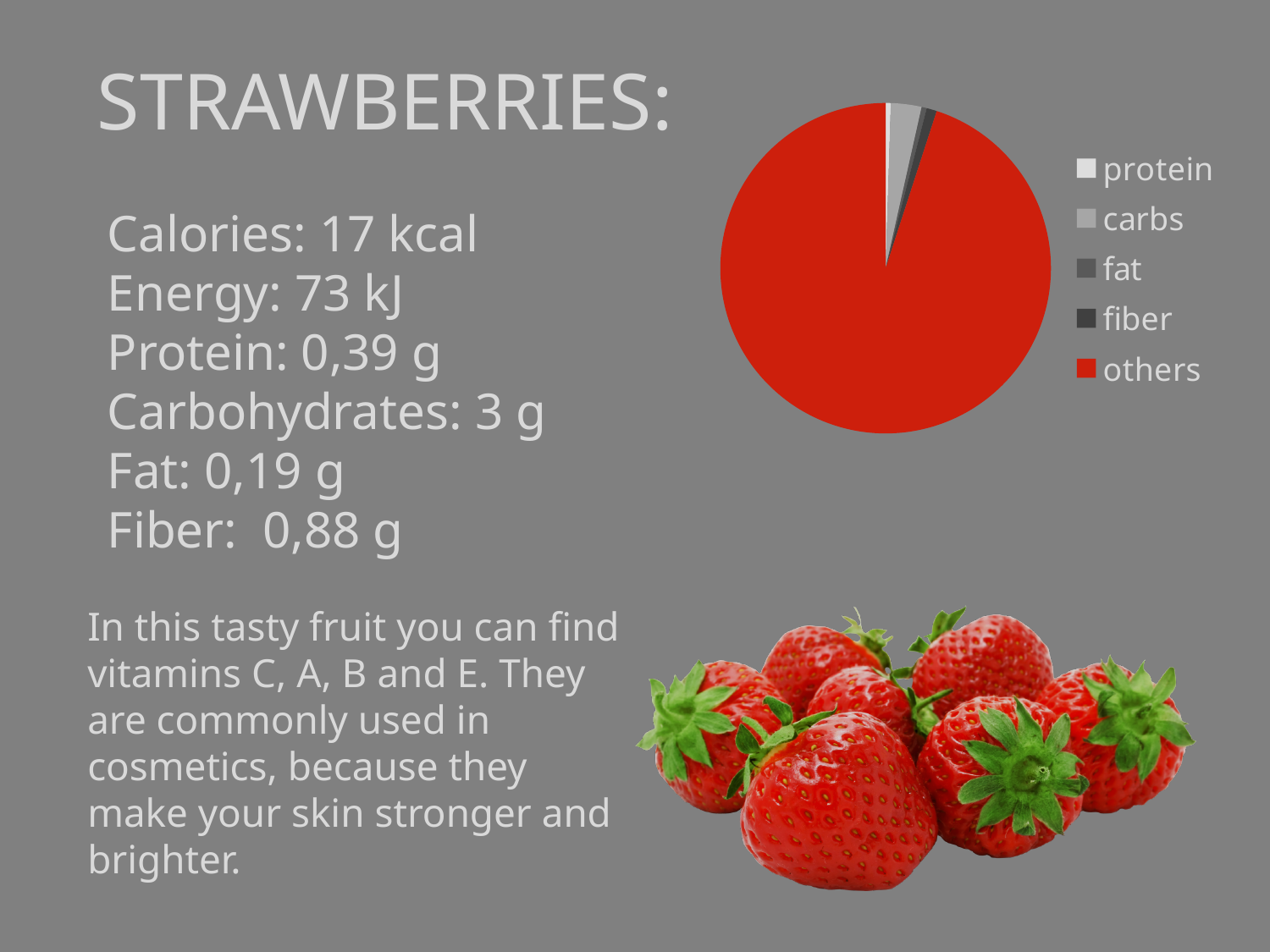
What kind of chart is shown on the slide? pie chart How many categories does the pie chart's legend list? 5 Which slice is larger in the pie chart, others or carbs? others Which slice is larger in the pie chart, others or fiber? others Which category is listed first in the pie chart's legend? protein What colour is the 'others' slice in the pie chart? red Which category takes up the largest slice of the pie chart? others